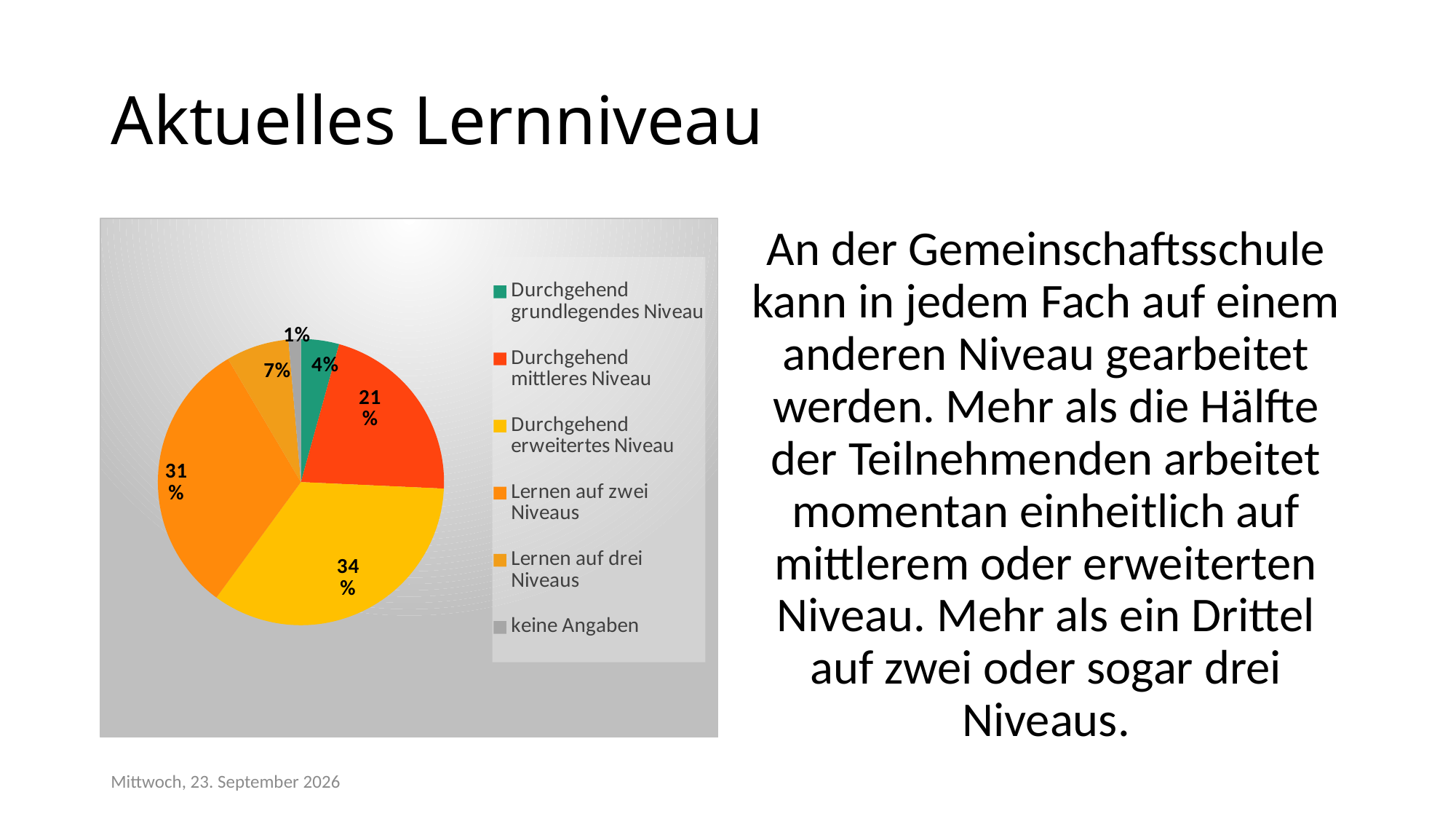
How many categories does the legend of the pie chart list? 6 Which is larger: the slice for "Durchgehend grundlegendes Niveau" or the slice for "Lernen auf drei Niveaus"? Lernen auf drei Niveaus What percentage is shown for "keine Angaben"? 1% What kind of chart is shown on the slide? pie chart Which category has the smallest slice of the pie? keine Angaben What is the difference in percentage points between "Durchgehend erweitertes Niveau" and "Durchgehend mittleres Niveau"? 13 What percentage of the pie is labelled for "Durchgehend erweitertes Niveau"? 34% Which category has the largest slice of the pie? Durchgehend erweitertes Niveau What percentage is shown for "Lernen auf drei Niveaus"? 7% What percentage is shown for "Lernen auf zwei Niveaus"? 31% What colour is the slice for "Durchgehend grundlegendes Niveau"? green What percentage is shown for "Durchgehend mittleres Niveau"? 21%